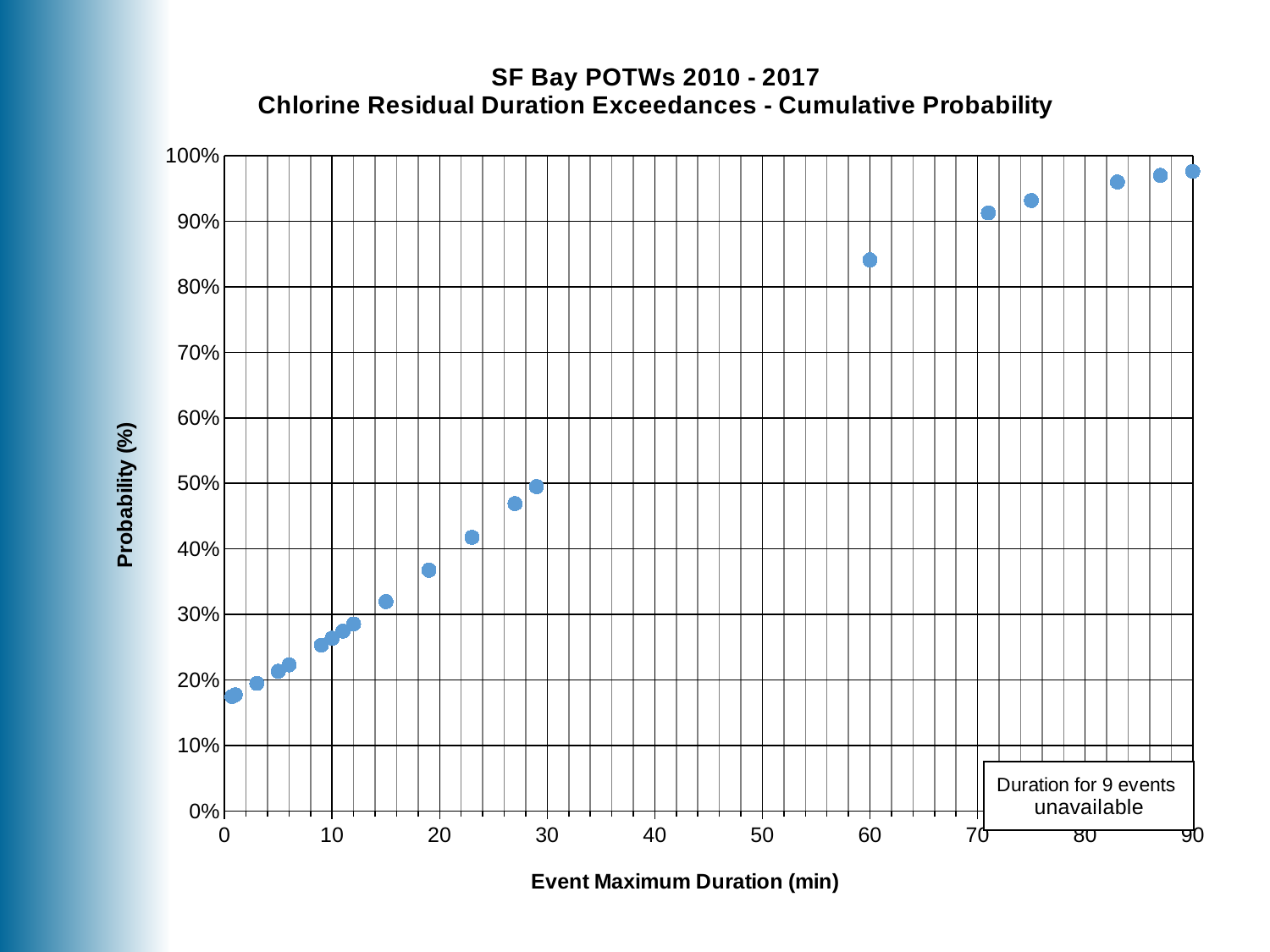
Which has the higher probability: the point at 60 min or the point at 30 min? The point at 60 min What kind of chart is shown on the slide? Scatter chart Is the probability for the point at an event maximum duration of 90 min greater or less than 90%? greater Is the probability for the point at an event maximum duration of 60 min greater or less than 80%? greater Is the probability for the point at an event maximum duration of 19 min greater or less than 40%? less According to the note on the chart, for how many events is the duration unavailable? 9 events What is the label of the x axis? Event Maximum Duration (min) Do the plotted probability values rise or fall as event maximum duration increases along the x axis? Rise